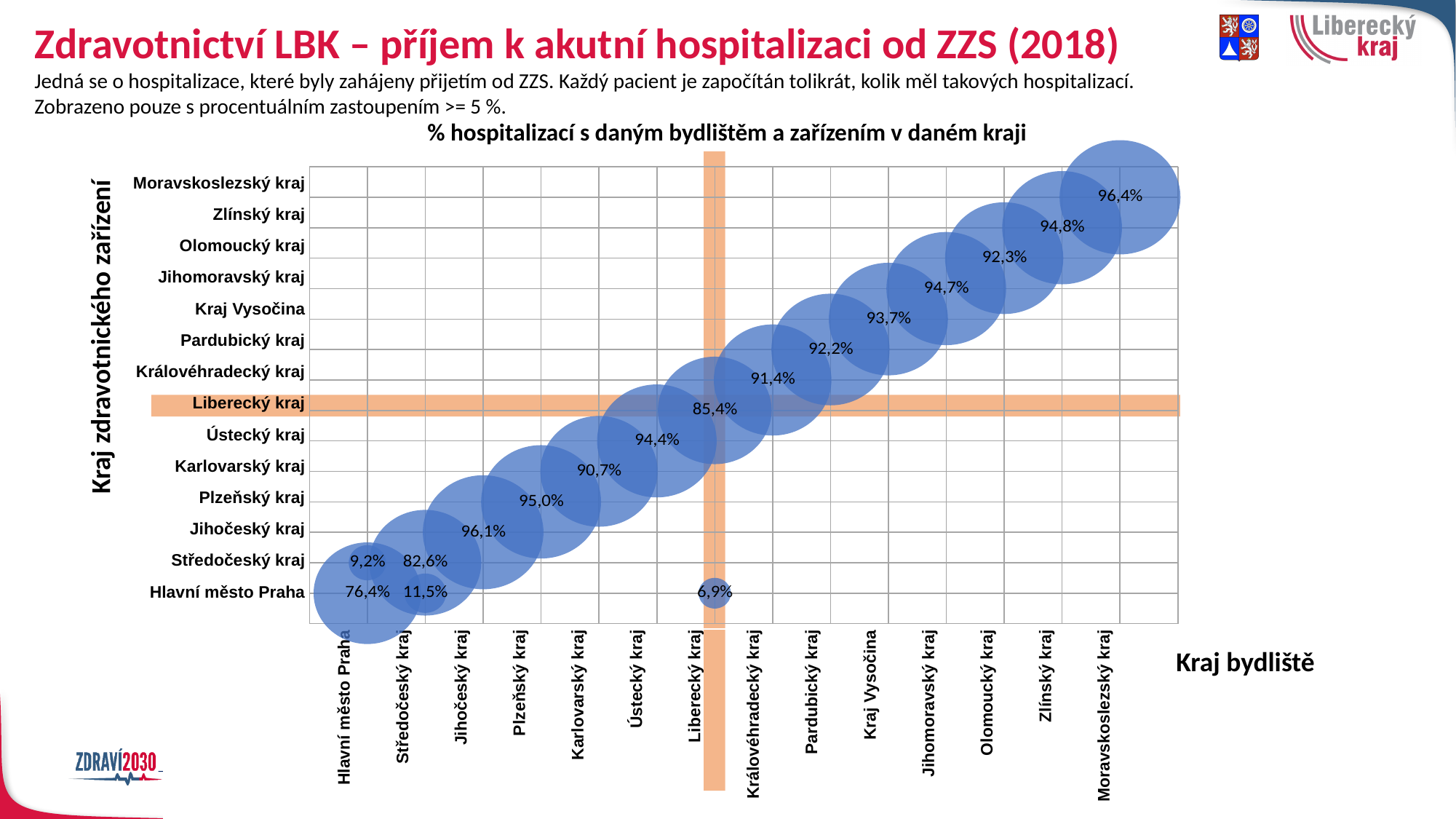
Which is larger: the same-region percentage for Hlavní město Praha or for Středočeský kraj? Středočeský kraj What is the chart's title? % hospitalizací s daným bydlištěm a zařízením v daném kraji What kind of chart is shown on the slide? bubble chart Which bubble shows the lowest percentage on the chart? 6,9% What percentage is shown for patients living in Hlavní město Praha hospitalised in a facility in Středočeský kraj? 9,2% What percentage is shown for patients living in Moravskoslezský kraj hospitalised in a facility in Moravskoslezský kraj? 96,4% What is the label of the vertical axis? Kraj zdravotnického zařízení What percentage is shown for patients living in Liberecký kraj hospitalised in a facility in Liberecký kraj? 85,4% Which residence region has the highest percentage of hospitalisations in a facility in the same region? Moravskoslezský kraj What percentage is shown for patients living in Liberecký kraj hospitalised in a facility in Hlavní město Praha? 6,9% What is the difference between the same-region percentage for Jihočeský kraj (96,1%) and for Liberecký kraj (85,4%)? 10,7 percentage points How many bubbles with data labels are plotted on the chart? 17